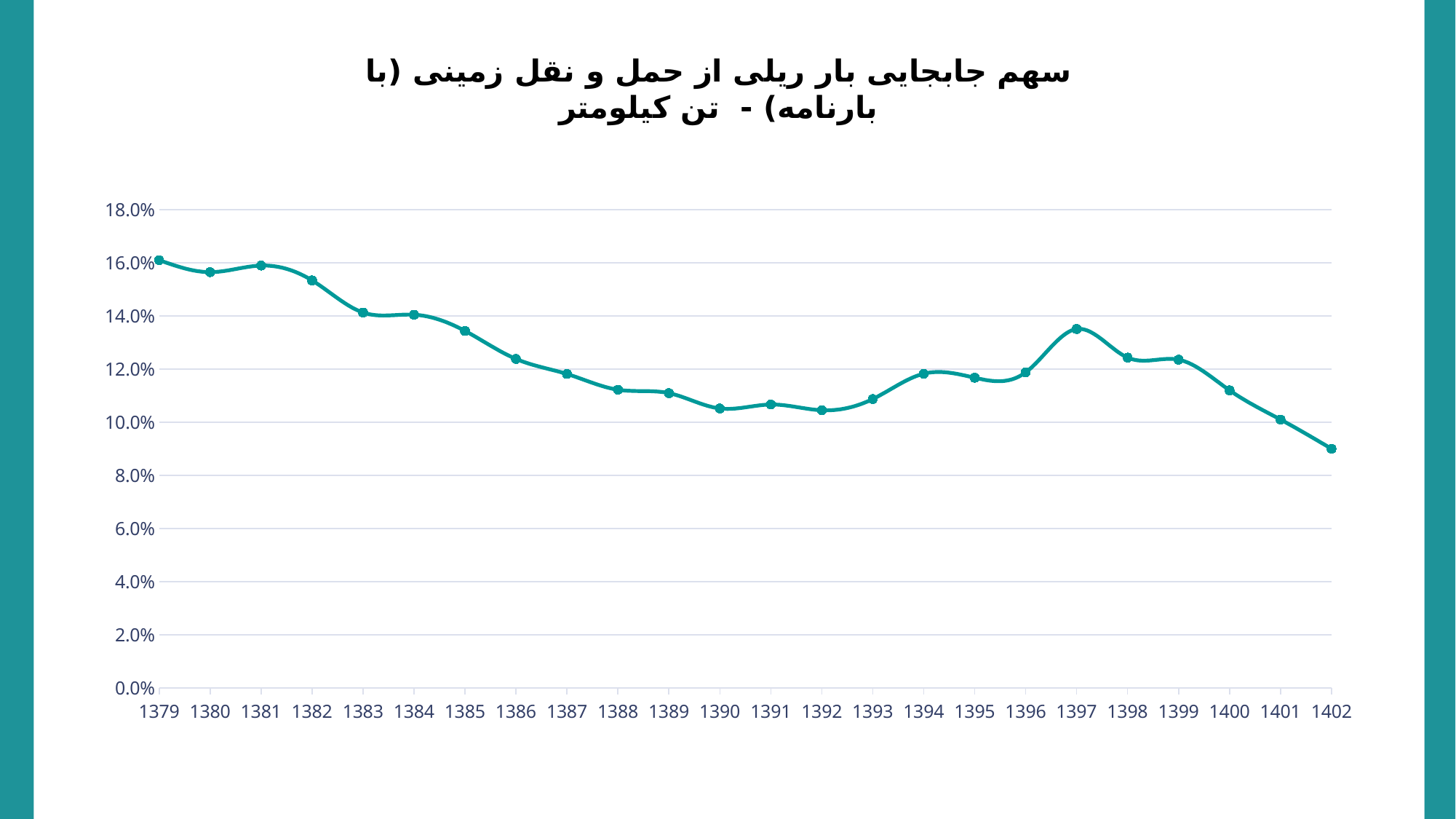
Overall, do the values rise or fall from 1379 to 1402? fall Which is larger, the value for 1379 or the value for 1402? 1379 Is the value for 1397 greater or less than 12.0%? greater Is the value for 1379 greater or less than 14.0%? greater What kind of chart is shown on the slide? line chart Is the value for 1385 greater or less than 14.0%? less Which is larger, the value for 1397 or the value for 1392? 1397 What is the highest tick label shown on the y axis? 18.0% How many years are plotted along the x axis? 24 Which year has the lowest value on the chart? 1402